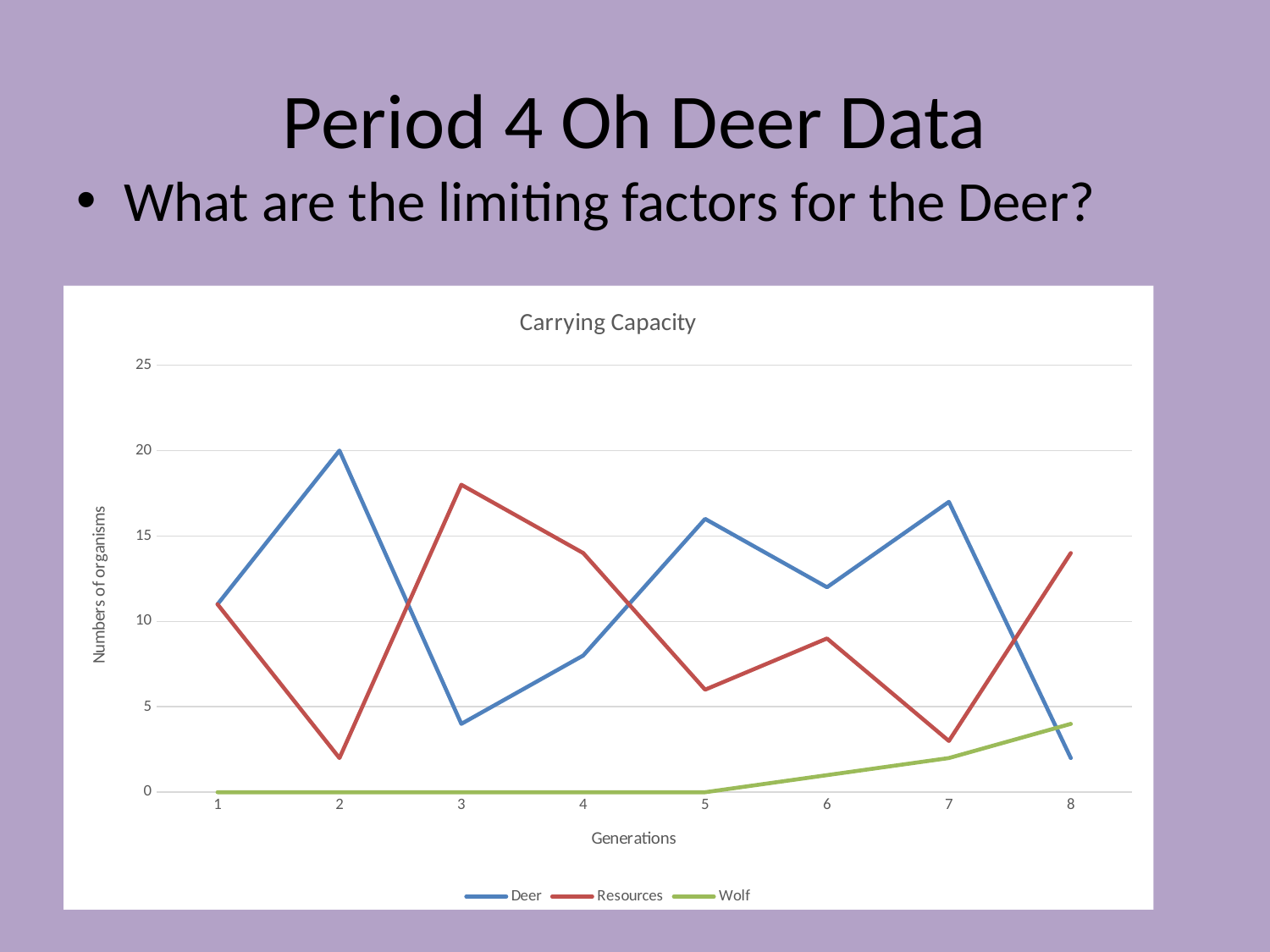
How many generations are plotted on the x axis? 8 At which generation is the Wolf value highest? 8 At generation 8, which is larger, Deer or Resources? Resources How many series does the legend list? 3 At which generation is the Resources value highest? 3 What type of chart is shown on the slide? line chart Is the value for Deer at generation 3 greater or less than 5? less Is the value for Resources at generation 3 greater or less than 15? greater What is the value for Wolf at generation 1? 0 What is the value for Deer at generation 2? 20 At which generation is the Deer value highest? 2 What is the title of the chart? Carrying Capacity